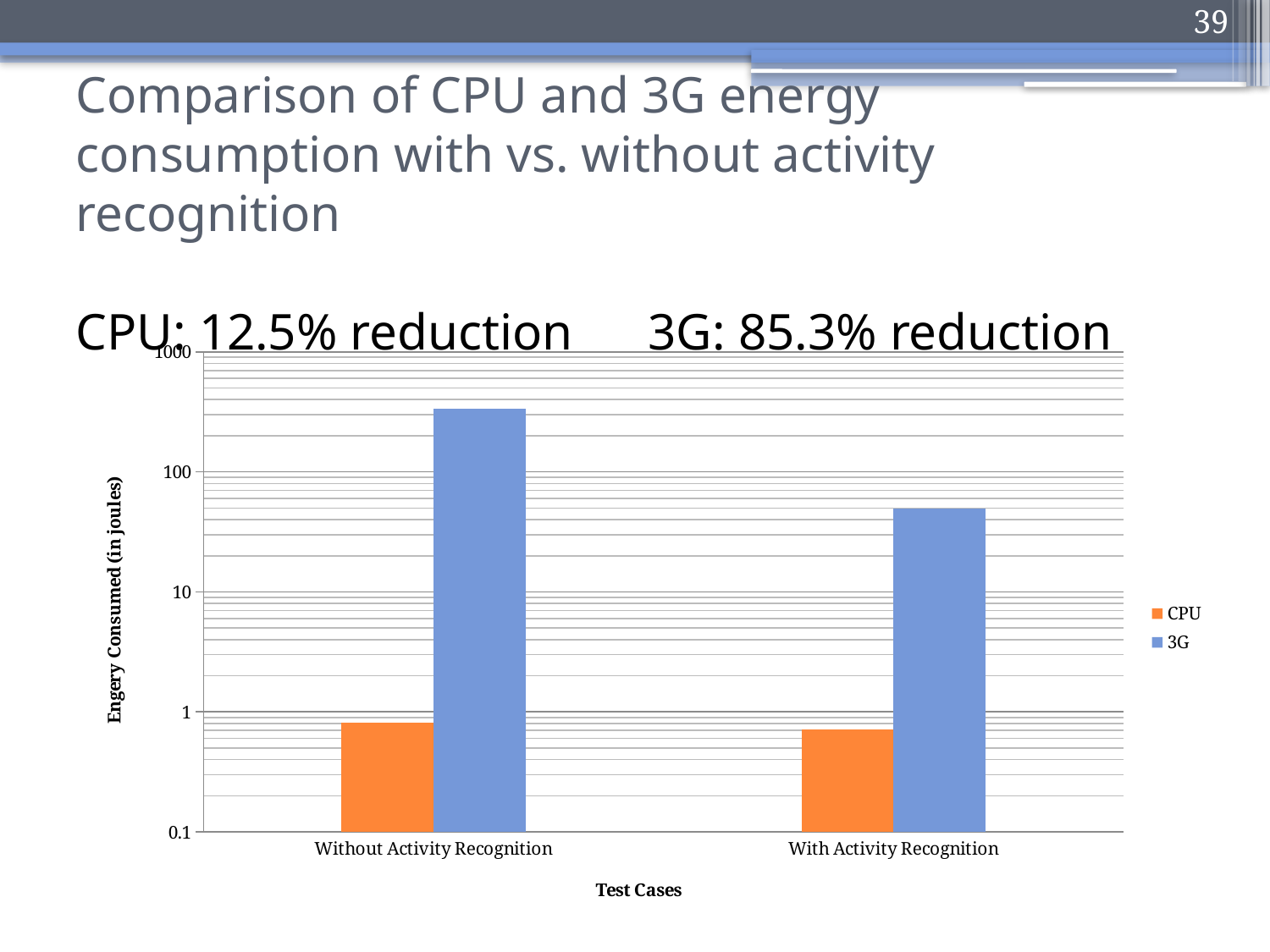
Is the 3G energy consumption larger Without Activity Recognition or With Activity Recognition? Without Activity Recognition For With Activity Recognition, which consumes more energy, CPU or 3G? 3G Is the 3G value for With Activity Recognition greater or less than 100? less Is the CPU value for Without Activity Recognition greater or less than 10? less Is the 3G value for Without Activity Recognition greater or less than 100? greater What is the label on the x axis of the chart? Test Cases How many test cases (categories) are shown on the x axis? 2 Does the 3G energy consumption rise or fall from Without Activity Recognition to With Activity Recognition? fall Which series and test case has the highest bar in the chart? 3G, Without Activity Recognition What kind of chart is shown on the slide? bar chart How many series does the chart legend list? 2